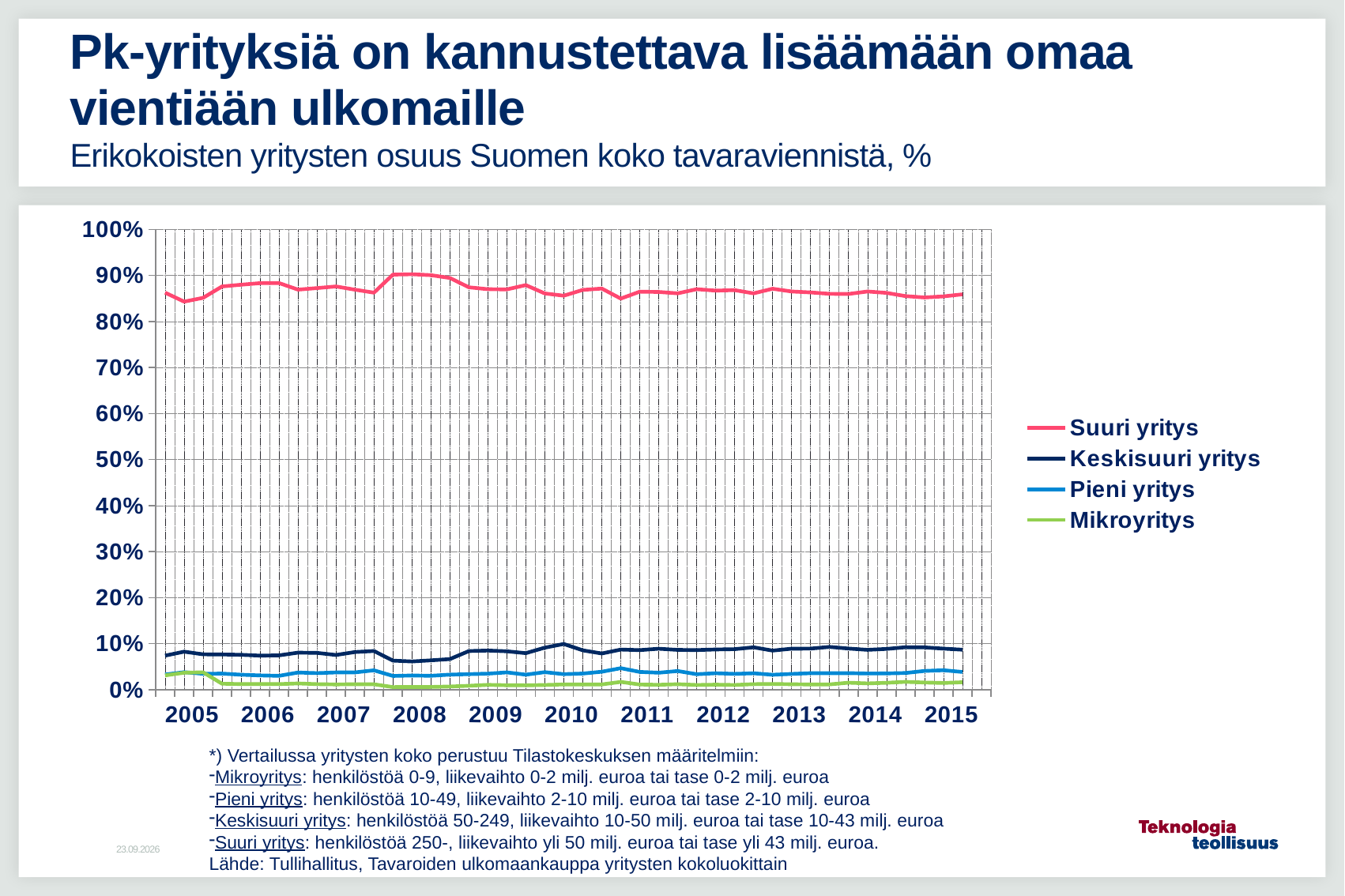
How many years are labelled on the x axis? 11 How many series does the legend list? 4 Which is larger in 2013, the value for Keskisuuri yritys or the value for Pieni yritys? Keskisuuri yritys Is the value for Keskisuuri yritys in 2012 greater or less than 20%? less Is the value for Pieni yritys in 2010 greater or less than 10%? less What kind of chart is shown on the slide? line chart Which series has the highest share of Finland's goods exports throughout the period? Suuri yritys Which series is drawn in green in the legend? Mikroyritys Is the value for Suuri yritys in 2015 greater or less than 90%? less What is the subtitle describing the chart's content? Erikokoisten yritysten osuus Suomen koko tavaraviennistä, %